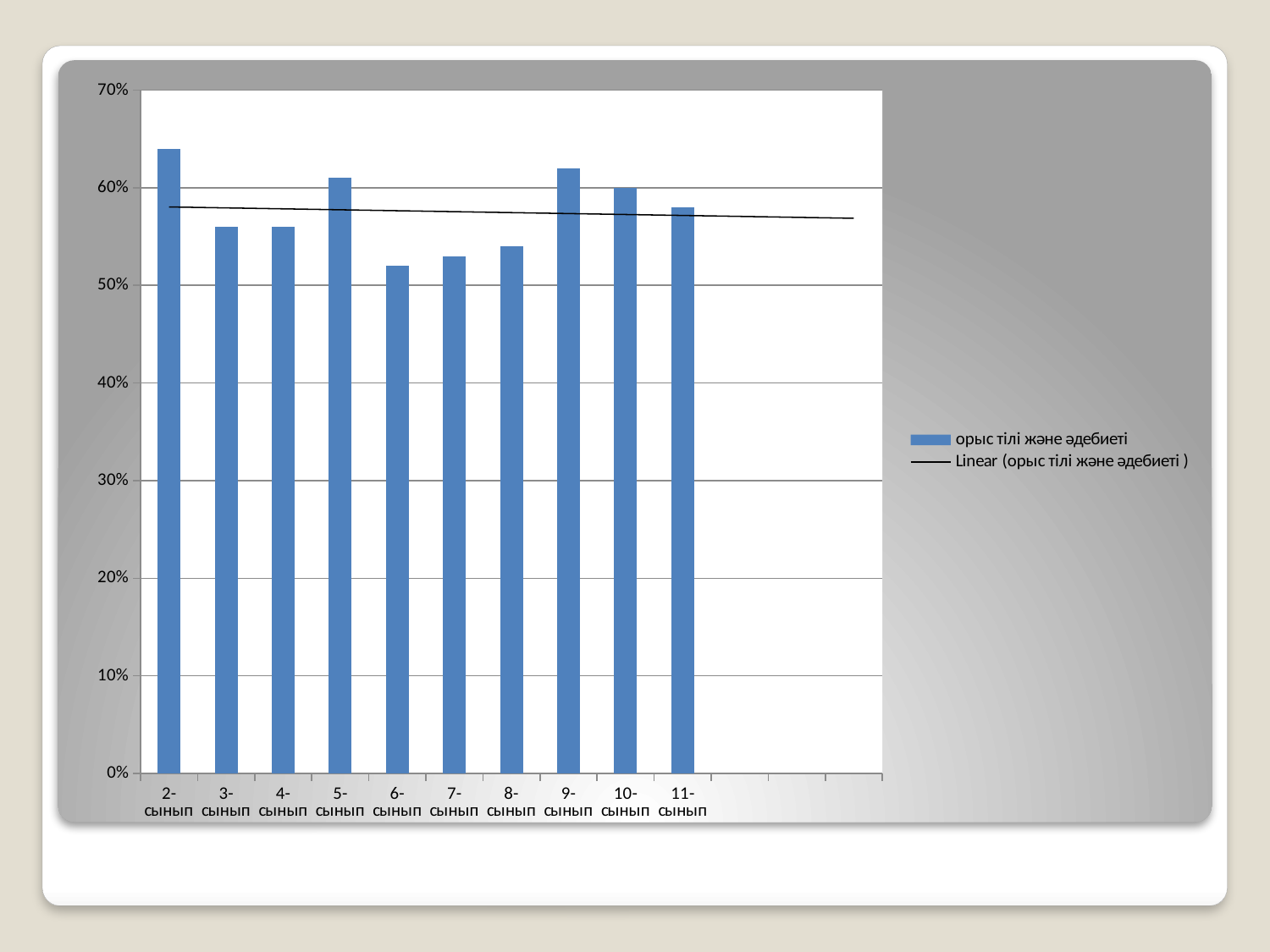
Is the value for 9-сынып greater or less than 60%? greater Is the value for 3-сынып greater or less than 60%? less Which is larger, the value for 2-сынып or the value for 6-сынып? 2-сынып Which class has the highest bar? 2-сынып What is the name of the bar series shown in the legend? орыс тілі және әдебиеті Which is larger, the value for 5-сынып or the value for 3-сынып? 5-сынып Is the value for 2-сынып greater or less than 60%? greater How many class categories (сынып) are plotted on the x axis? 10 How many entries does the legend list? 2 What kind of chart is shown on the slide? bar chart